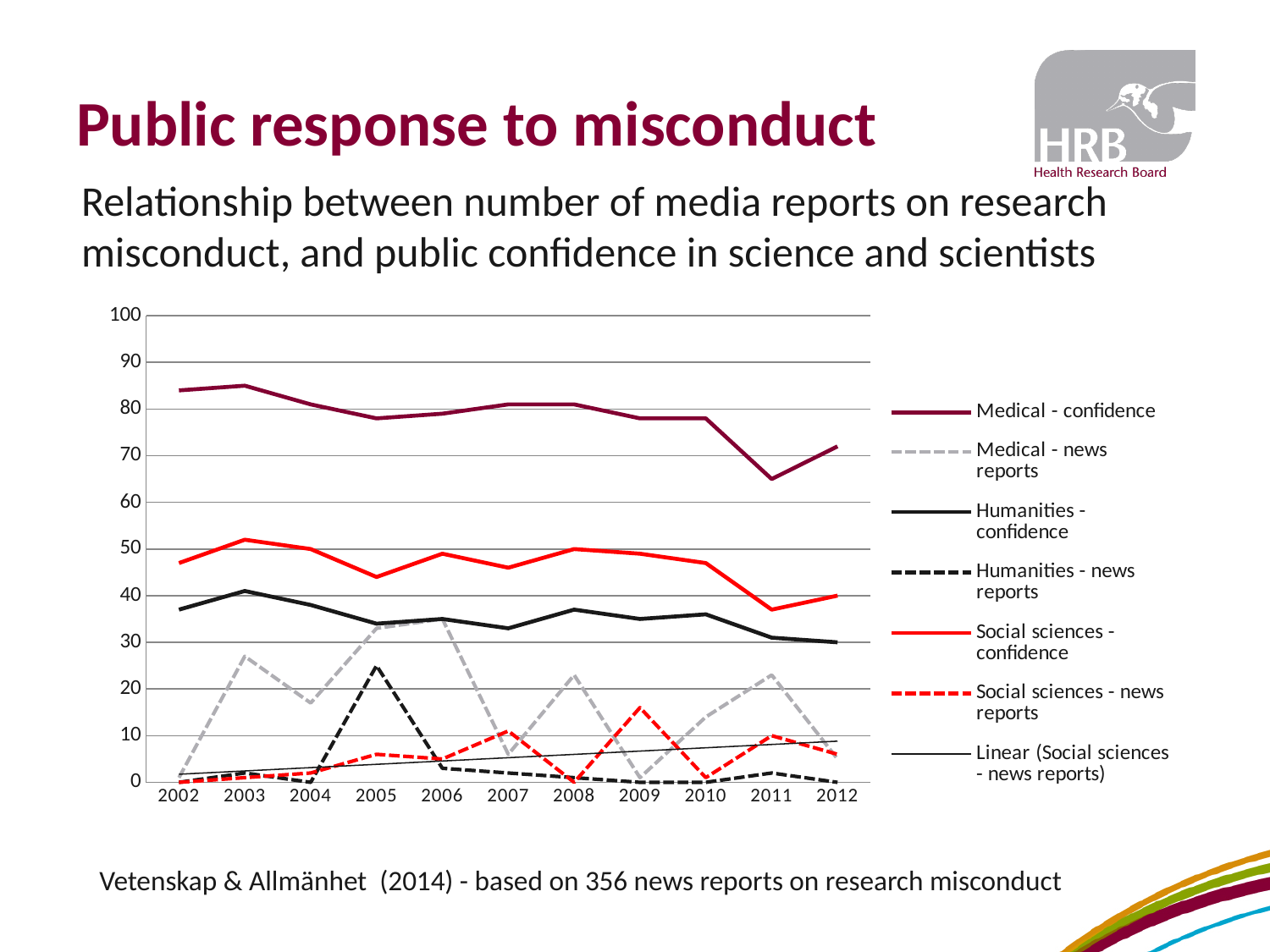
Which is larger in 2002: Medical - confidence or Social sciences - confidence? Medical - confidence In which year is the Humanities - confidence value highest? 2003 In which year is the Medical - confidence value lowest? 2011 According to the note below the chart, how many news reports on research misconduct is the data based on? 356 In which year is the Social sciences - confidence value lowest? 2011 What kind of chart is shown on the slide? Line chart Does the Medical - confidence line overall rise or fall from 2002 to 2012? Fall In which year is the Humanities - news reports value highest? 2005 How many years are shown along the x axis? 11 Is the Medical - confidence value for 2011 greater or less than 70? less Is the Humanities - news reports value for 2005 greater or less than 20? greater How many series does the legend list? 7